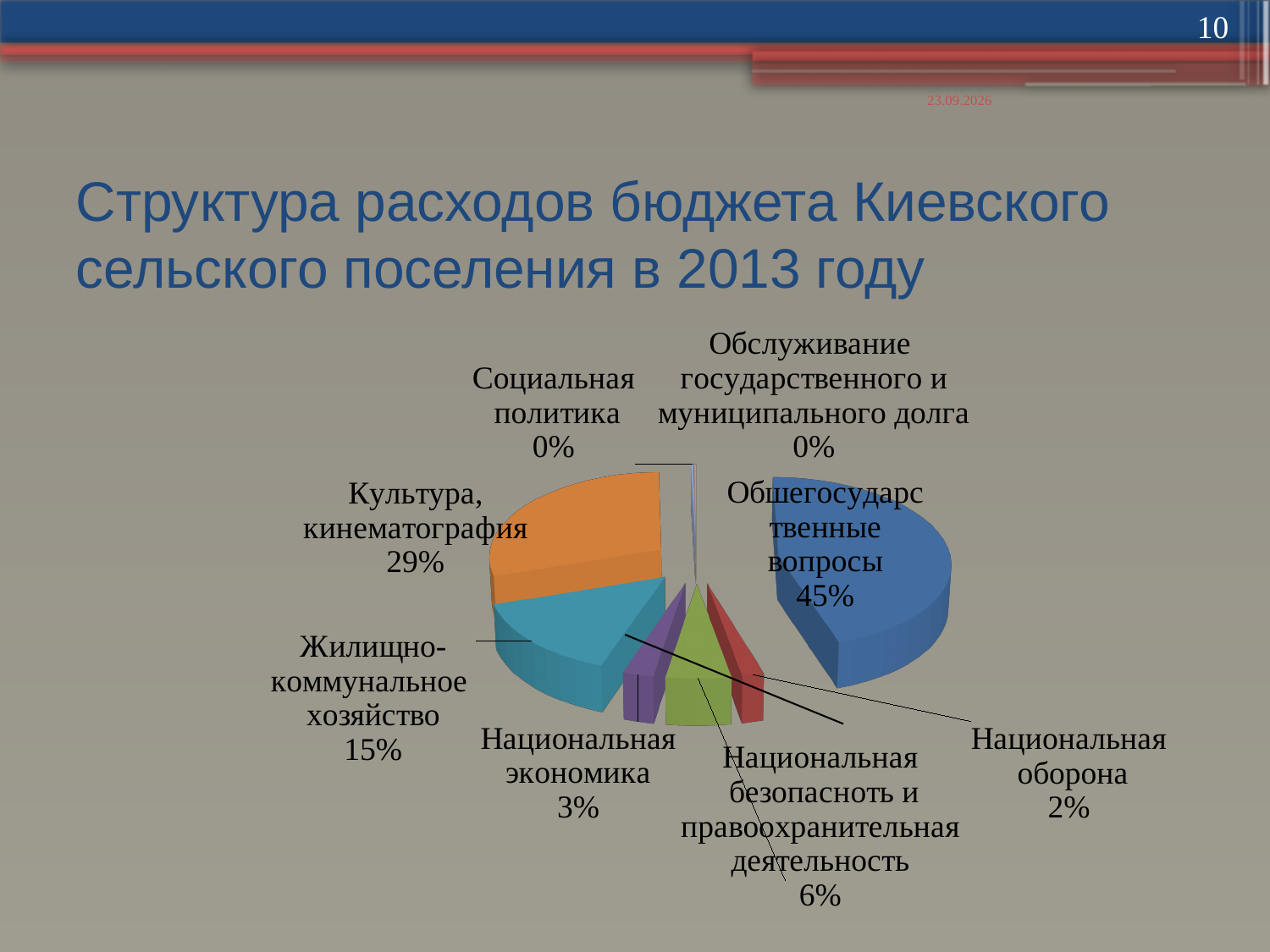
What share is shown for Социальная политика? 0% What is the title of the slide containing the chart? Структура расходов бюджета Киевского сельского поселения в 2013 году Which is larger: the share for Жилищно-коммунальное хозяйство or the share for Национальная экономика? Жилищно-коммунальное хозяйство What is the difference in percentage points between Общегосударственные вопросы and Культура, кинематография? 16 What share of expenditure goes to Национальная оборона? 2% Which category has the largest share of the pie? Общегосударственные вопросы What share of expenditure goes to Национальная безопасность и правоохранительная деятельность? 6% What kind of chart is shown on the slide? pie chart How many categories are labelled on the pie chart? 8